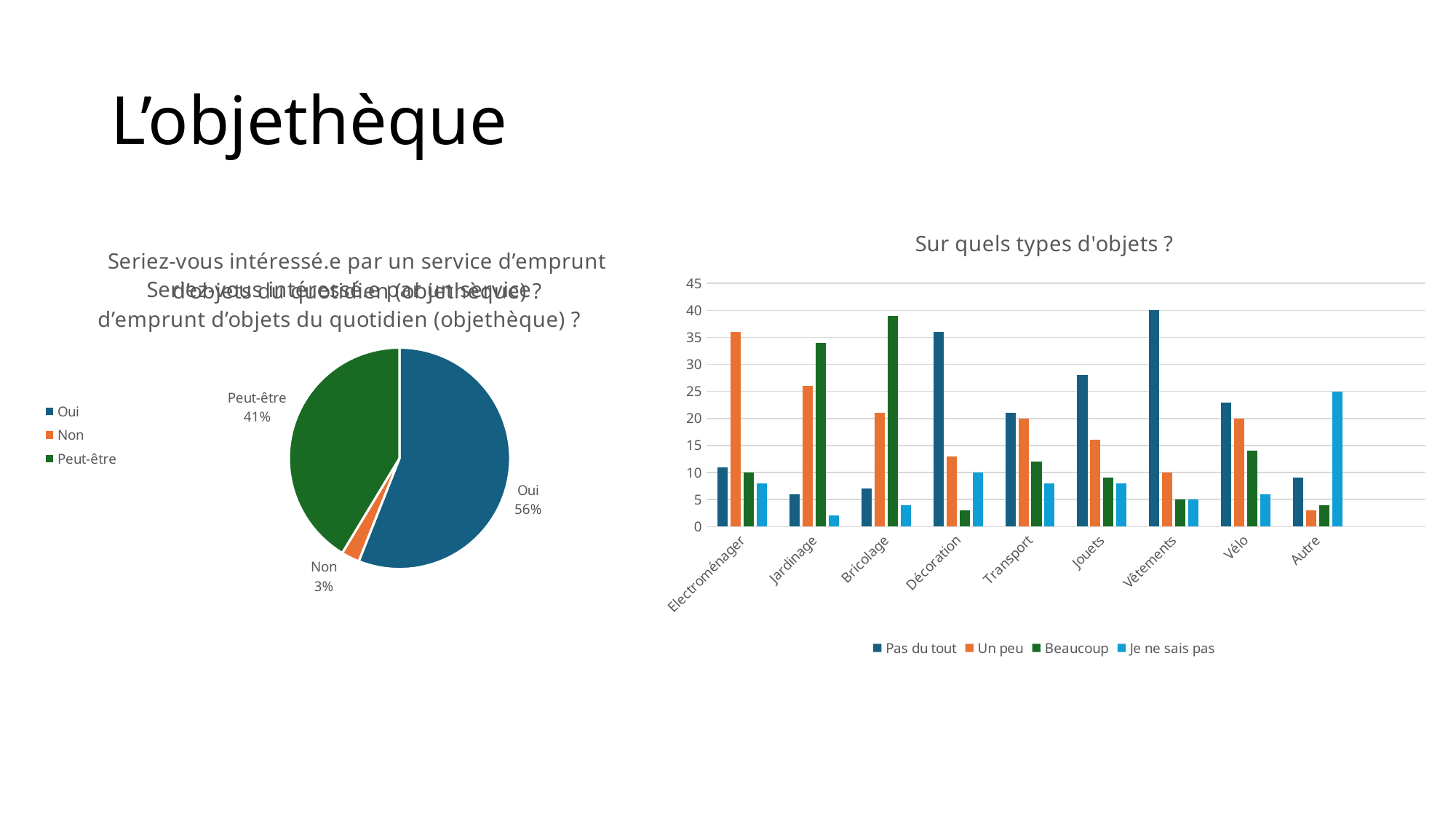
On the pie chart on the left, which answer has the smallest share? Non On the pie chart on the left, what share of respondents answered "Non"? 3% On the pie chart on the left, what share of respondents answered "Oui"? 56% On the chart "Sur quels types d'objets ?", how many series does the legend list? 4 On the pie chart on the left, which answer has the largest share? Oui On the chart "Sur quels types d'objets ?", how many object categories are shown on the x axis? 9 On the chart "Sur quels types d'objets ?", which category has the highest "Beaucoup" value? Bricolage What kind of chart is the chart titled "Sur quels types d'objets ?"? Bar chart On the pie chart on the left, how many slices does the pie have? 3 On the chart "Sur quels types d'objets ?", is the "Pas du tout" value for Vêtements greater or less than 35? greater On the chart "Sur quels types d'objets ?", is the "Je ne sais pas" value for Autre greater or less than 20? greater On the pie chart on the left, how many percentage points larger is the "Oui" share than the "Peut-être" share? 15 percentage points